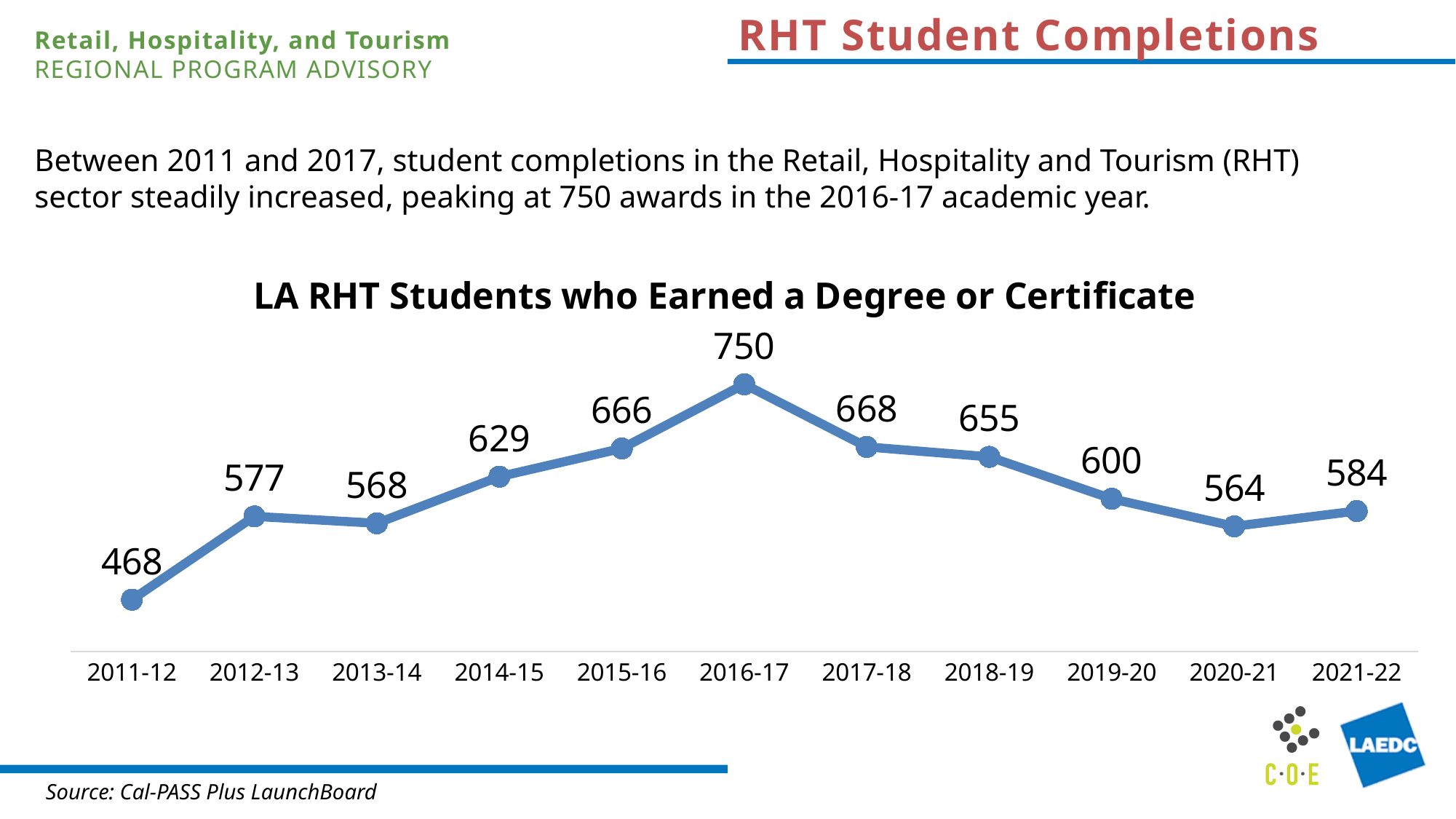
What is the title of the chart? LA RHT Students who Earned a Degree or Certificate Which is larger, the value for 2019-20 or the value for 2021-22? 2019-20 What is the difference between the values for 2012-13 and 2011-12? 109 What kind of chart is shown? Line chart Which academic year has the lowest value? 2011-12 Which academic year has the highest value? 2016-17 What is the difference between the values for 2016-17 and 2017-18? 82 What is the value for 2016-17? 750 What is the value for 2011-12? 468 How many academic years are plotted on the chart? 11 Do the values rise or fall from 2016-17 to 2020-21? Fall What is the value for 2021-22? 584